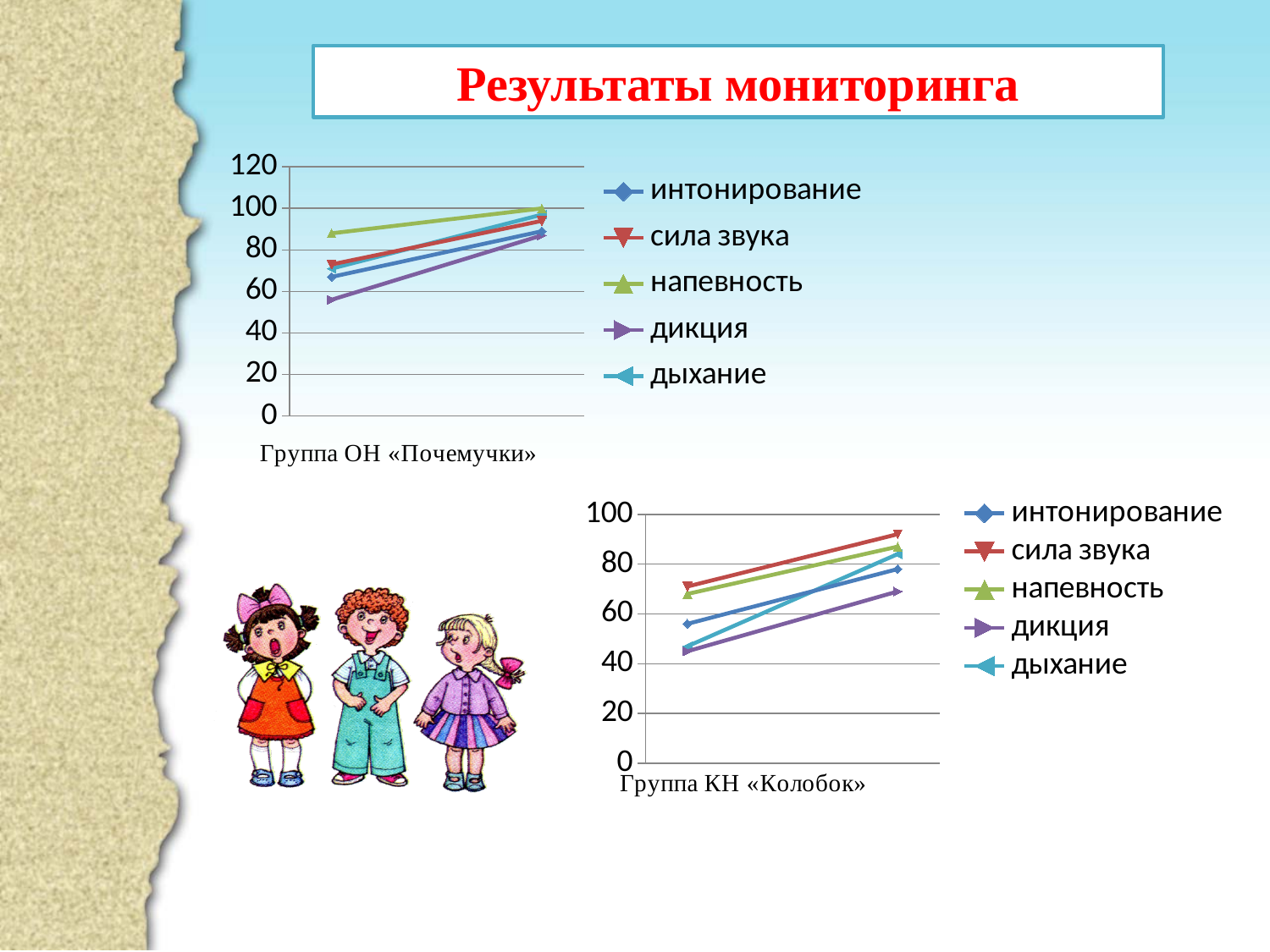
In the «Группа КН «Колобок»» chart, does the сила звука line rise or fall from left to right? rise In the «Группа ОН «Почемучки»» chart, is the first value for дикция greater or less than 60? less In the «Группа ОН «Почемучки»» chart, is the first value for напевность greater or less than 80? greater In the «Группа КН «Колобок»» chart, is the last value for дикция greater or less than 80? less What is the maximum value shown on the vertical axis of the «Группа ОН «Почемучки»» chart? 120 What kind of chart is the «Группа ОН «Почемучки»» chart? line chart In the «Группа КН «Колобок»» chart, which series has the highest value at the last point? сила звука In the «Группа ОН «Почемучки»» chart, which series has the lowest value at the first point? дикция In the «Группа КН «Колобок»» chart, which series has the lowest value at the last point? дикция In the «Группа ОН «Почемучки»» chart, does the дикция line rise or fall from left to right? rise In the «Группа ОН «Почемучки»» chart, which series has the highest value at the first point? напевность How many series does the legend of the «Группа КН «Колобок»» chart list? 5